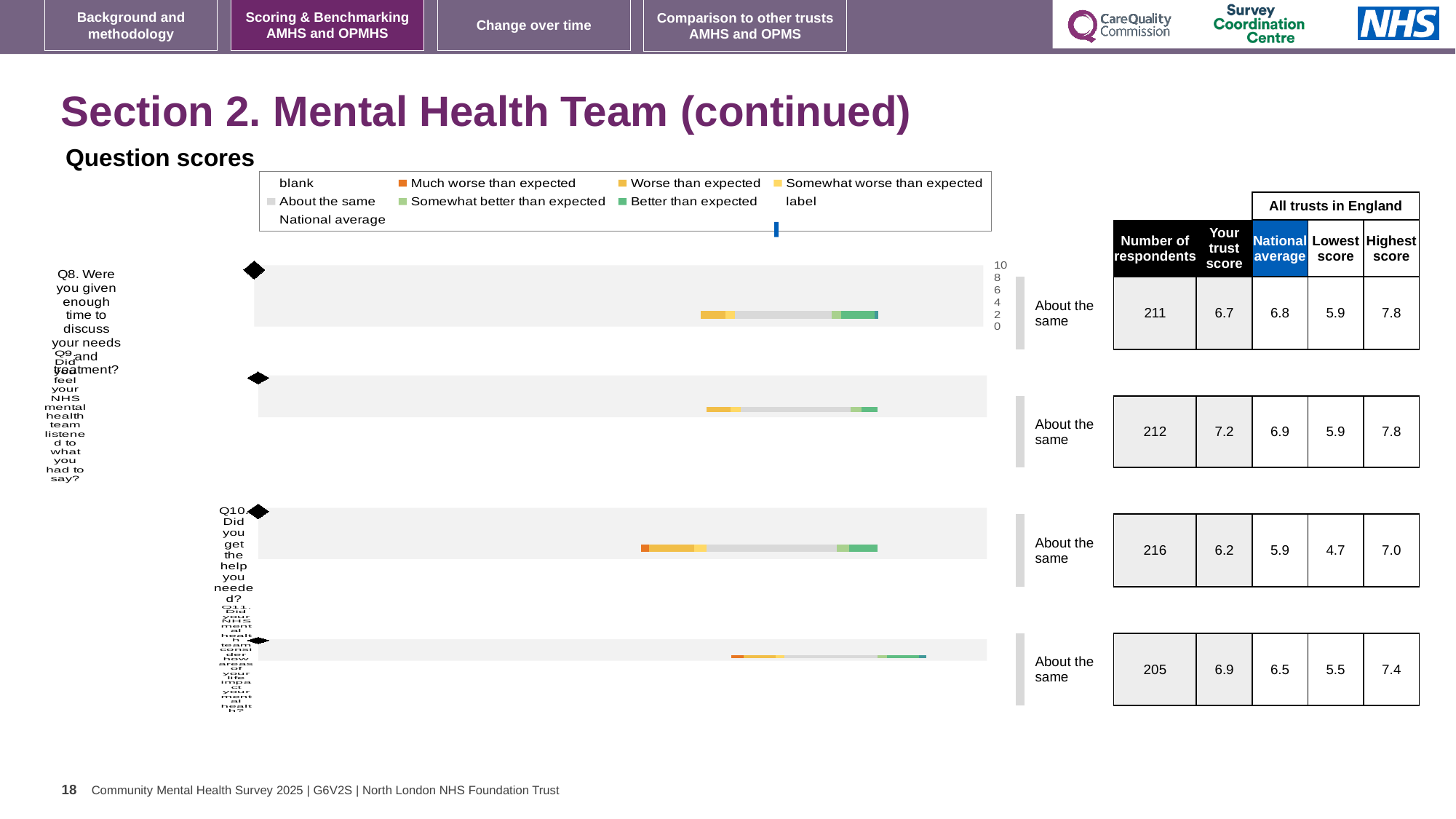
What is the highest tick value on the axis of the Q8 chart? 10 In the table next to the Q11 chart, what is the highest score among all trusts in England? 7.4 In the table next to the Q8 chart, what is the number of respondents? 211 How many question charts (Q8 to Q11) are shown on the slide? 4 Which legend entry is shown with an orange colour? Much worse than expected For Q9, what is the difference between your trust score and the national average in the table? 0.3 What kind of chart is used for the question scores on this slide? bar chart In the table next to the Q9 chart, what is your trust score? 7.2 For Q10, which is larger in the table: your trust score or the national average? Your trust score In the table next to the Q10 chart, what is the lowest score among all trusts in England? 4.7 Which question (Q8, Q9, Q10 or Q11) has the highest number of respondents in the table? Q10 How many entries does the legend above the charts list? 9